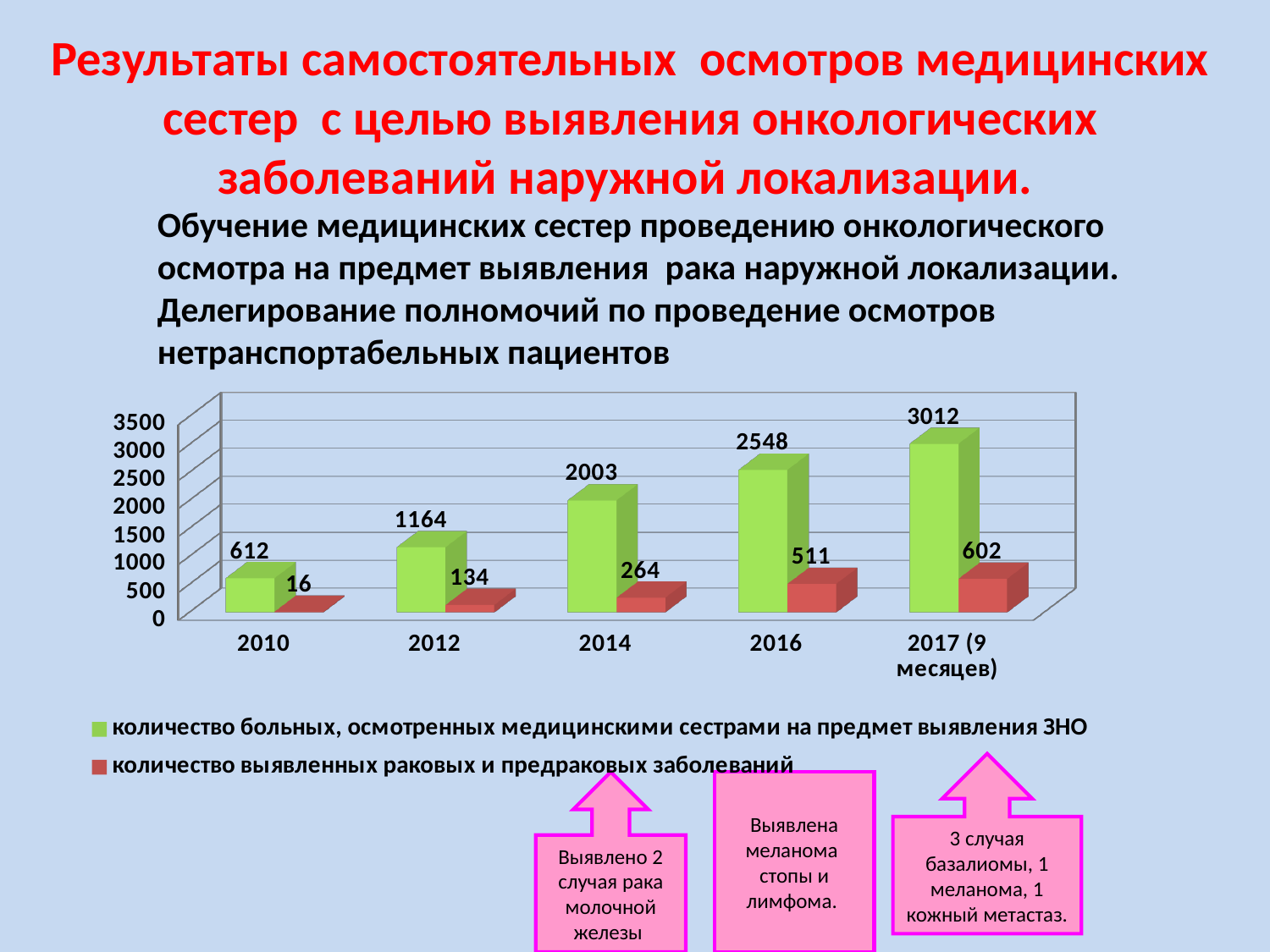
In which year was the number of patients examined by nurses the highest? 2017 (9 месяцев) Is the number of patients examined in 2012 greater or less than 1000? greater How many series does the chart legend list? 2 How many cancerous and precancerous diseases were detected in 2012? 134 How many patients were examined by nurses for detection of malignant neoplasms (ЗНО) in 2014? 2003 In which year was the number of detected cancerous and precancerous diseases the lowest? 2010 Which colour represents the number of detected cancerous and precancerous diseases in the chart? red What type of chart is shown on the slide? bar chart What is the difference between the number of patients examined in 2016 and in 2014? 545 Does the number of patients examined by nurses rise or fall from 2010 to 2017 (9 месяцев)? rise How many years (categories) are shown on the x axis of the chart? 5 Which is larger: the number of detected diseases in 2016 or in 2017 (9 месяцев)? 2017 (9 месяцев)